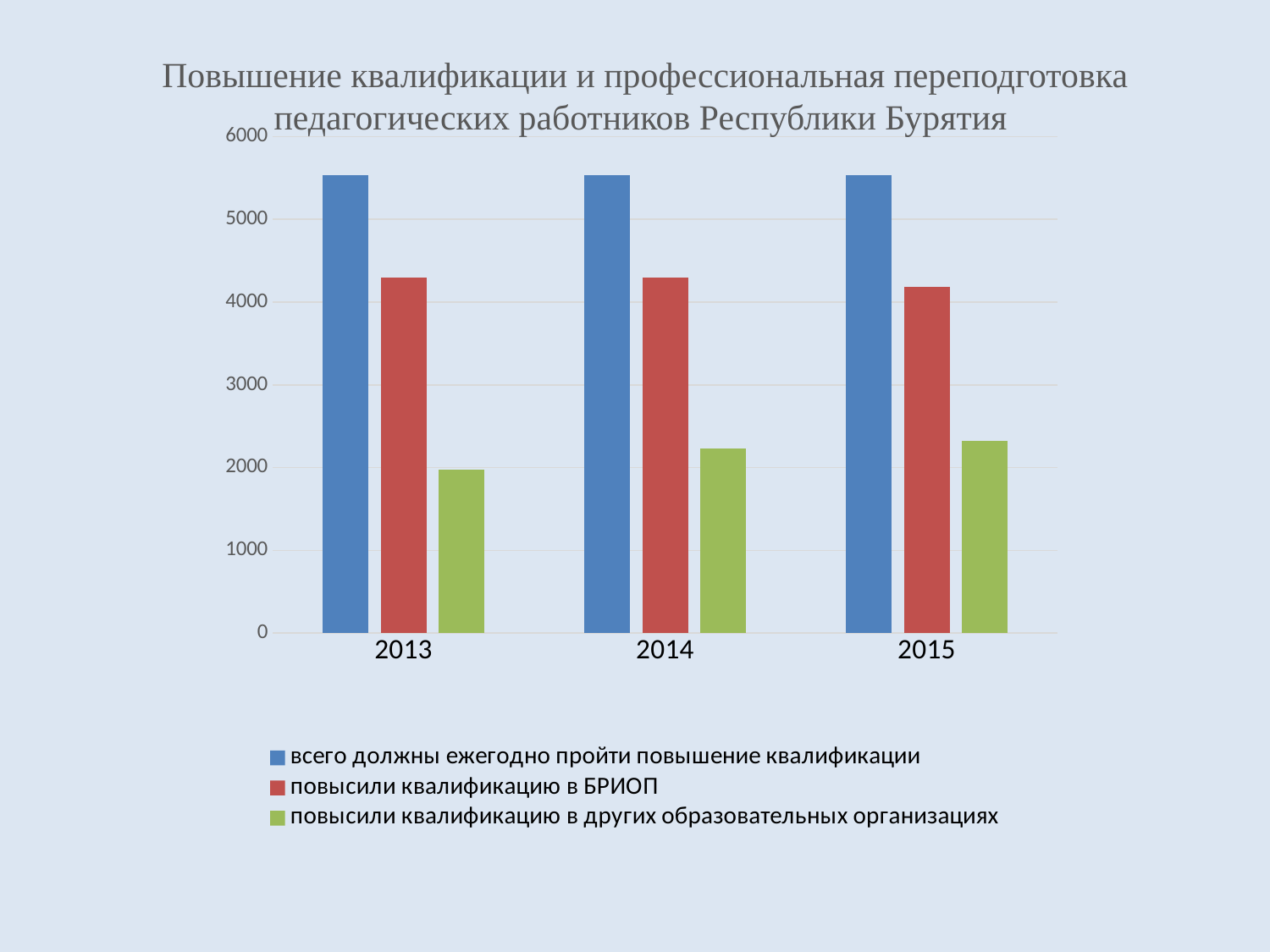
What colour represents 'повысили квалификацию в БРИОП' in the legend? red How many years are shown on the x axis? 3 Is the value for 'повысили квалификацию в БРИОП' in 2014 greater or less than 4000? greater For 'повысили квалификацию в других образовательных организациях', which is larger: 2013 or 2015? 2015 What kind of chart is shown on the slide? bar chart How many series does the legend list? 3 Which series has the highest value in every year? всего должны ежегодно пройти повышение квалификации Is the value for 'всего должны ежегодно пройти повышение квалификации' in 2013 greater or less than 5000? greater In 2015, which is larger: 'повысили квалификацию в БРИОП' or 'повысили квалификацию в других образовательных организациях'? повысили квалификацию в БРИОП Is the value for 'повысили квалификацию в других образовательных организациях' in 2014 greater or less than 2000? greater Which year has the lowest value for 'повысили квалификацию в других образовательных организациях'? 2013